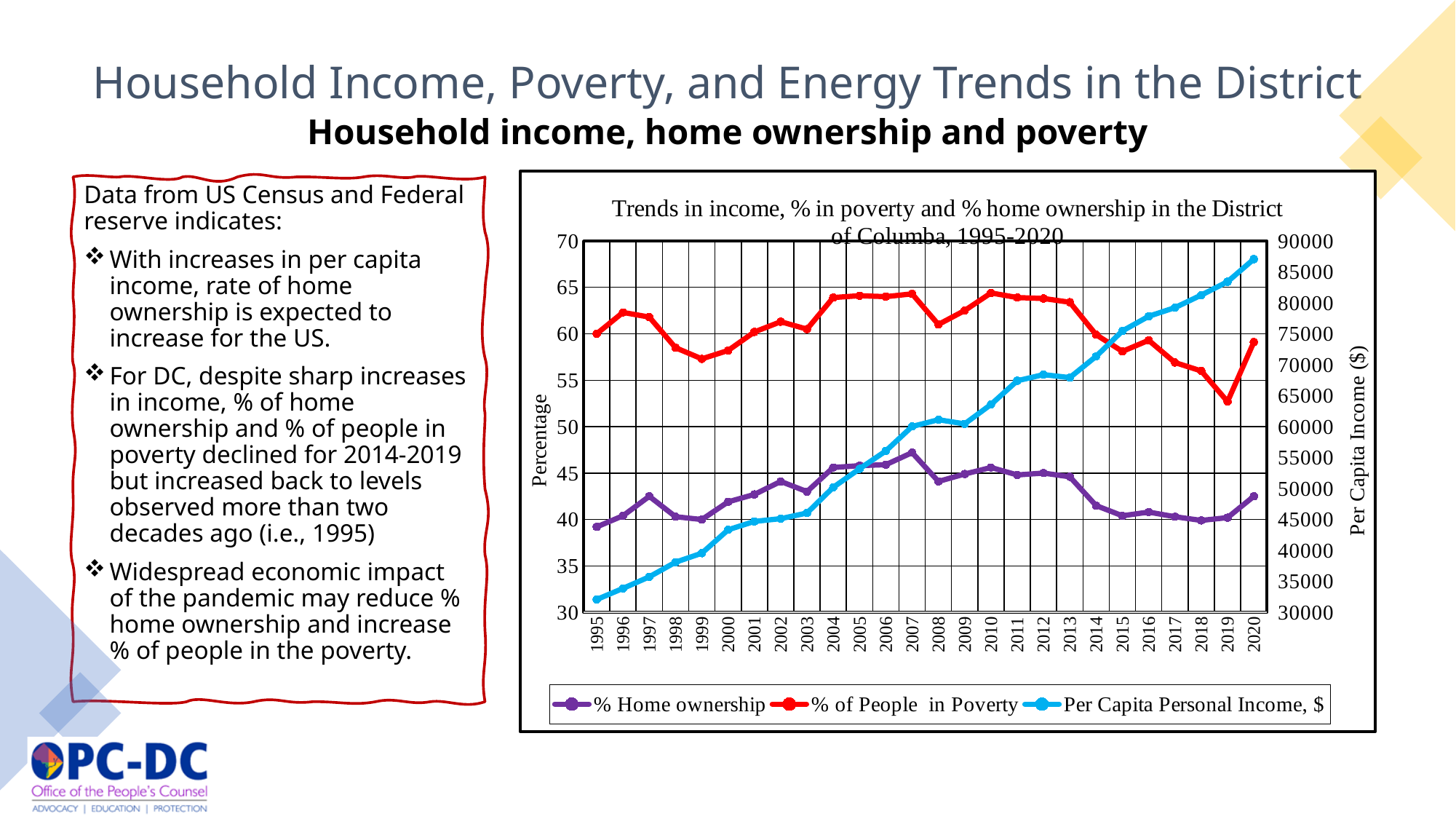
Does the Per Capita Personal Income series rise or fall from 1995 to 2020? rise Is the value for Per Capita Personal Income in 1995 greater or less than 35000? less How many series does the chart legend list? 3 In which year is % of People in Poverty at its lowest? 2019 In which year is % Home ownership at its highest? 2007 What kind of chart is shown on the slide? line chart Which is larger: % of People in Poverty in 2010 or in 2019? 2010 In which year is Per Capita Personal Income at its highest? 2020 Which colour is used for the % of People in Poverty line? red Is the value for % Home ownership in 2007 greater or less than 45? greater How many years are plotted along the x axis of the chart? 26 Is the value for % of People in Poverty in 2019 greater or less than 55? less